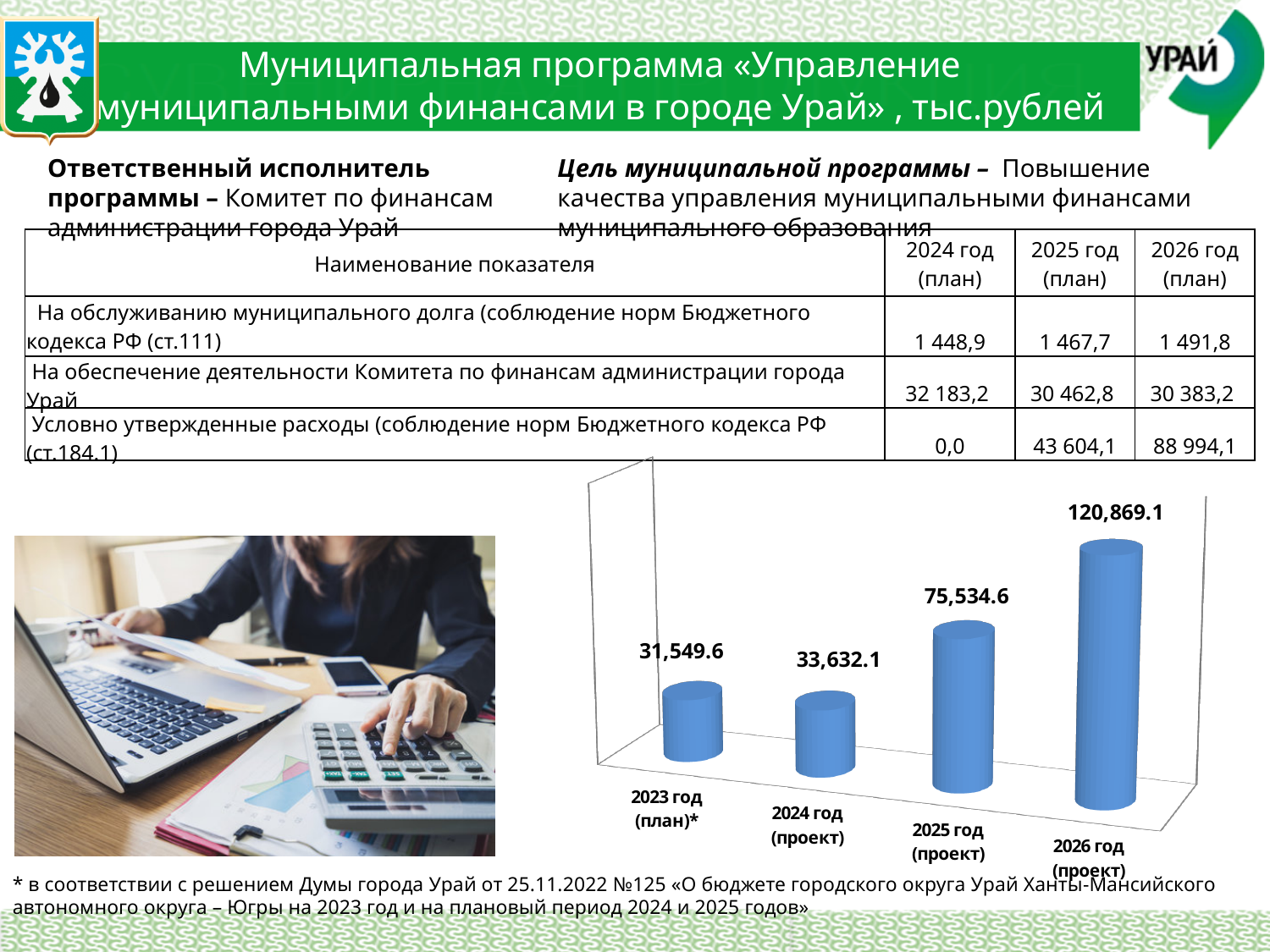
What is the value shown for 2023 год (план)* in the bar chart? 31,549.6 What is the difference between the values for 2026 год (проект) and 2025 год (проект) in the bar chart? 45,334.5 What is the value shown for 2024 год (проект) in the bar chart? 33,632.1 What type of chart is shown at the bottom right of the slide? Bar chart What is the value shown for 2025 год (проект) in the bar chart? 75,534.6 Which is larger in the bar chart: the value for 2024 год (проект) or the value for 2023 год (план)*? 2024 год (проект) Which year has the lowest value in the bar chart? 2023 год (план)* What is the value shown for 2026 год (проект) in the bar chart? 120,869.1 What is the difference between the values for 2024 год (проект) and 2023 год (план)* in the bar chart? 2,082.5 Which year has the highest value in the bar chart? 2026 год (проект) How many bars are shown in the bar chart? 4 Do the values in the bar chart rise or fall from 2023 to 2026? Rise